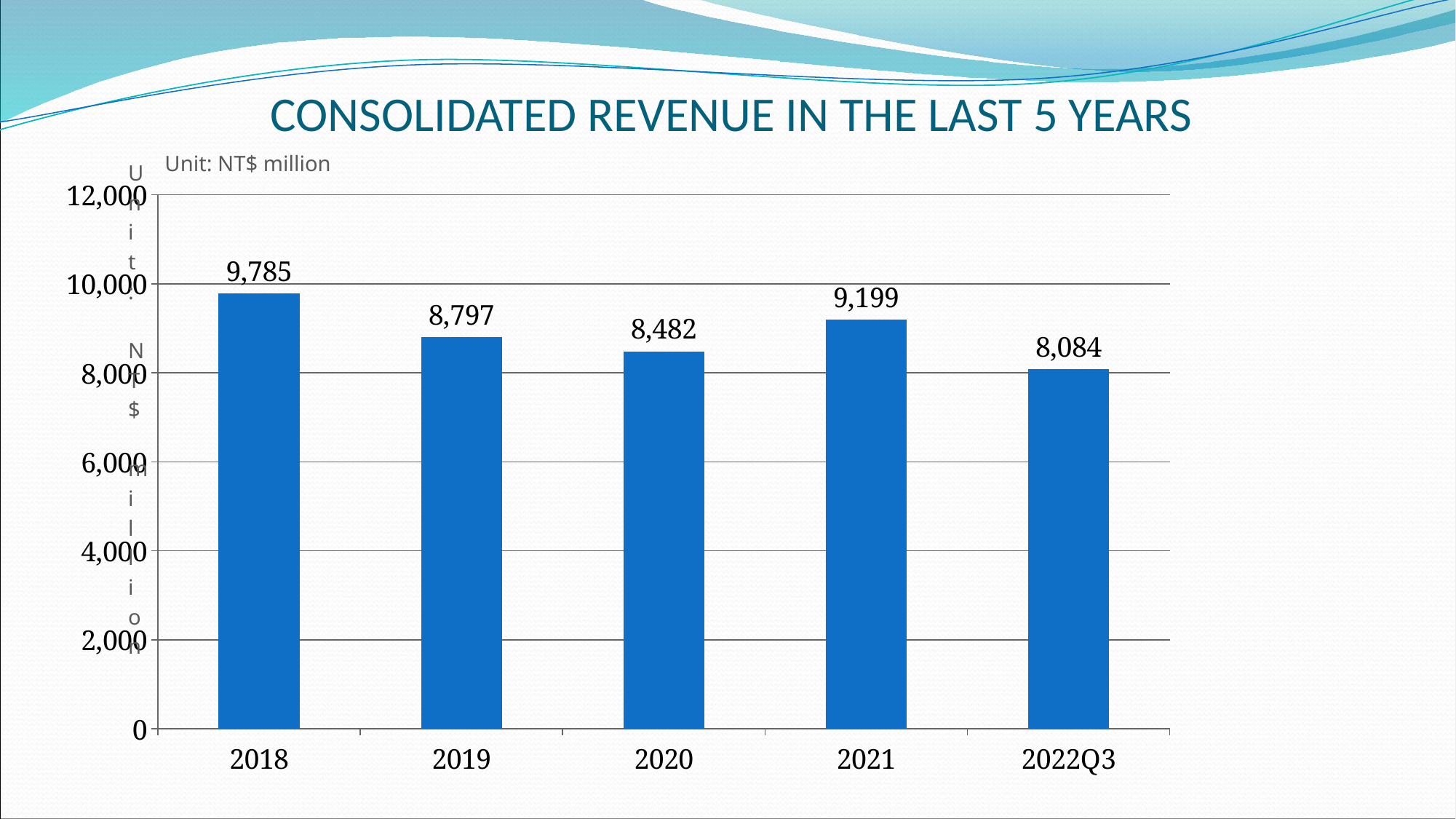
Which is larger, the revenue in 2019 or the revenue in 2021? 2021 What unit is the revenue expressed in, according to the note above the chart? NT$ million What is the consolidated revenue for 2020? 8,482 What is the consolidated revenue for 2022Q3? 8,084 What is the consolidated revenue for 2018? 9,785 What is the difference between the revenue in 2018 and the revenue in 2019? 988 Is the value for 2021 greater or less than 10,000? less How many periods are shown on the x axis? 5 Which year has the highest consolidated revenue? 2018 Which period has the lowest consolidated revenue? 2022Q3 What kind of chart is shown on the slide? bar chart What is the difference between the revenue in 2021 and the revenue in 2020? 717